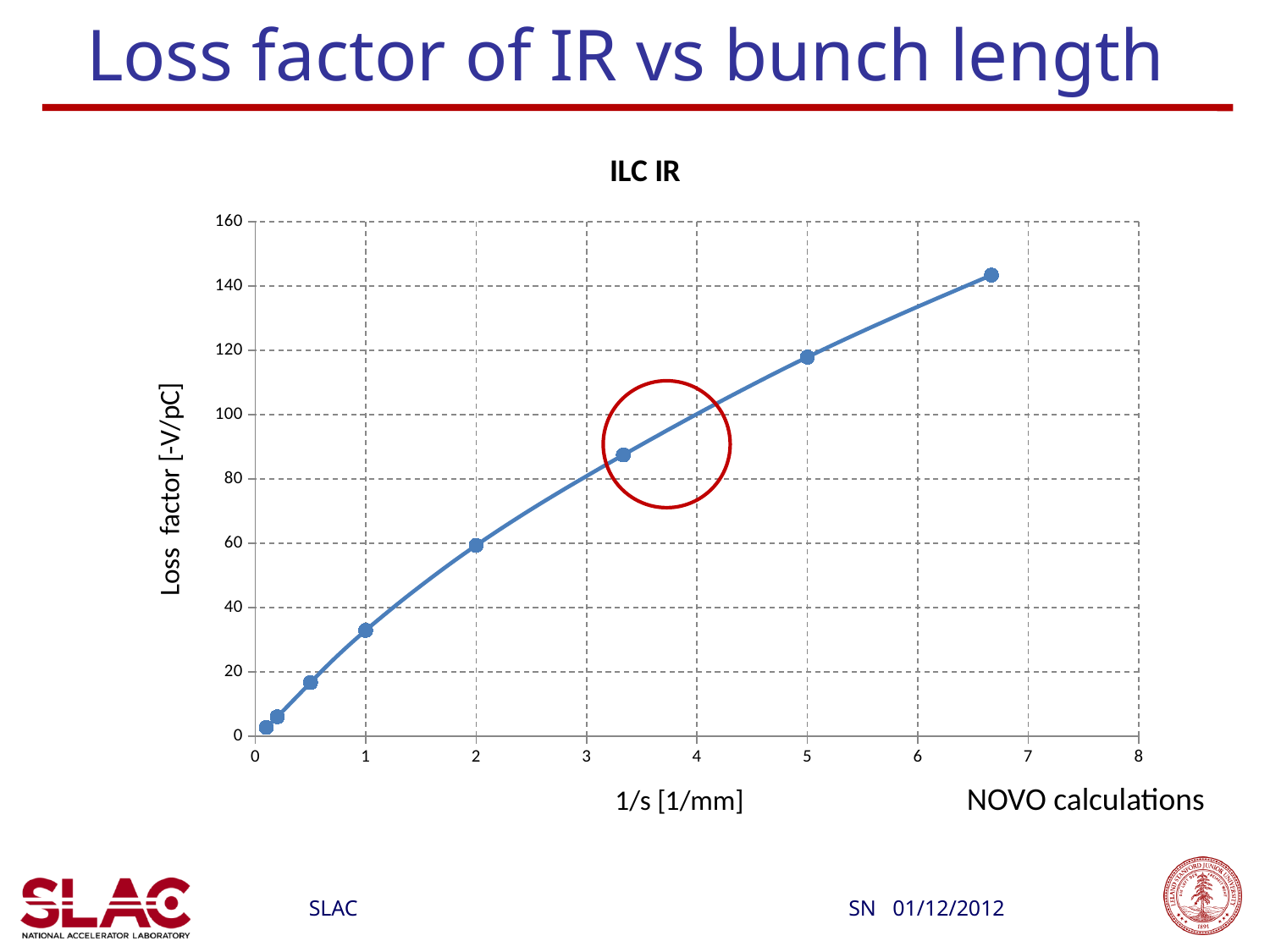
Does the loss factor rise or fall as 1/s increases along the x axis? rise Is the loss factor at 1/s = 2 greater or less than 40? greater What is the title of the chart? ILC IR Is the loss factor of the rightmost data point greater or less than 120? greater Is the loss factor of the circled data point greater or less than 80? greater What is the label of the y axis? Loss factor [-V/pC] What type of chart is shown on the slide? line chart How many data points are plotted on the chart? 8